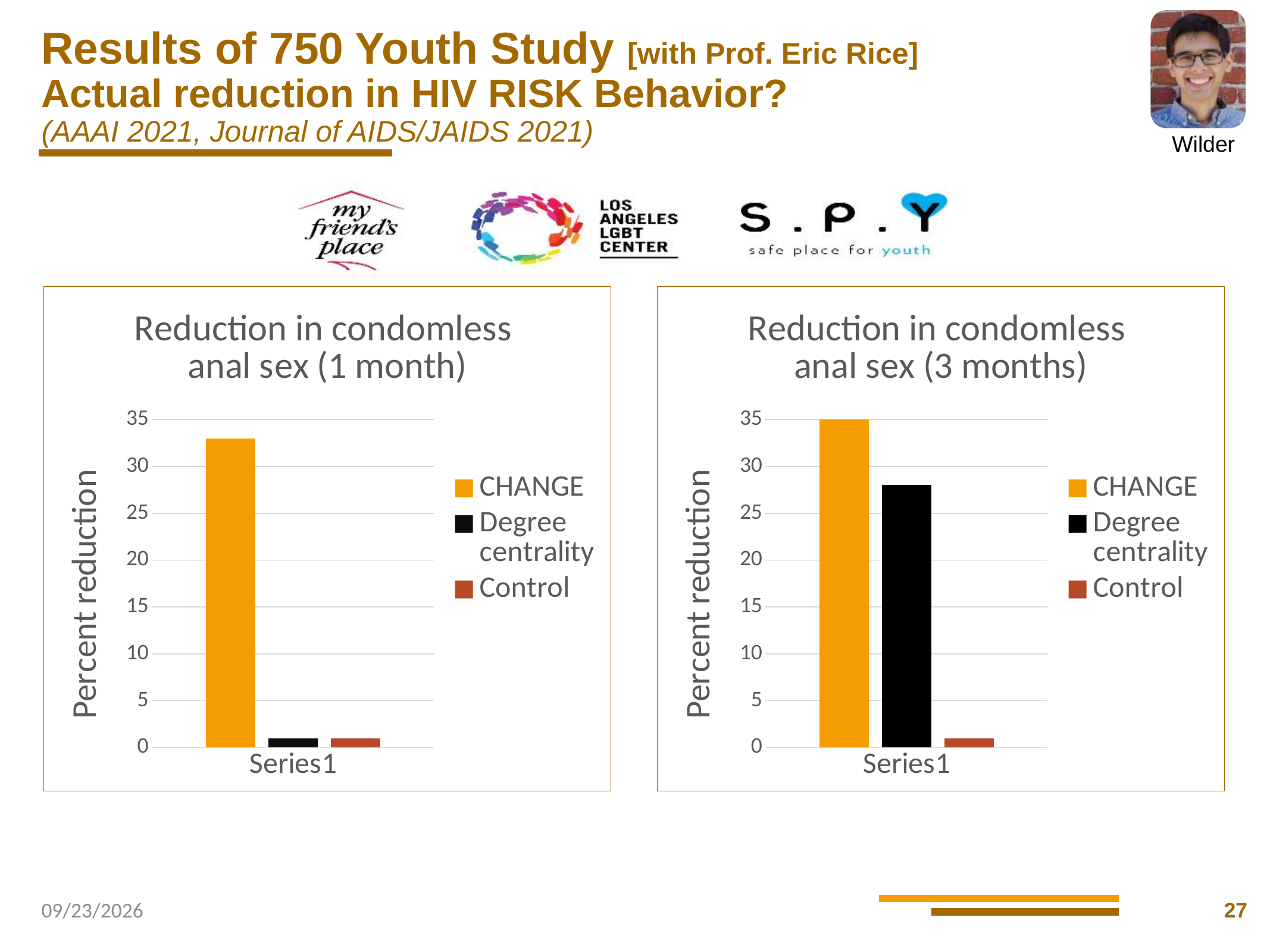
In the 'Reduction in condomless anal sex (3 months)' chart, which is larger, the value for CHANGE or the value for Degree centrality? CHANGE In the 'Reduction in condomless anal sex (3 months)' chart, is the value for Control greater or less than 5? less In the 'Reduction in condomless anal sex (1 month)' chart, which is larger, the value for CHANGE or the value for Degree centrality? CHANGE In the 'Reduction in condomless anal sex (3 months)' chart, which series has the lowest percent reduction? Control In the 'Reduction in condomless anal sex (3 months)' chart, which series has the highest percent reduction? CHANGE How many series does the legend list in the 'Reduction in condomless anal sex (3 months)' chart? 3 What is the y-axis label of the 'Reduction in condomless anal sex (3 months)' chart? Percent reduction In the 'Reduction in condomless anal sex (3 months)' chart, is the value for Degree centrality greater or less than 25? greater In the 'Reduction in condomless anal sex (1 month)' chart, is the value for CHANGE greater or less than 30? greater What kind of chart is the 'Reduction in condomless anal sex (1 month)' chart? bar chart In the 'Reduction in condomless anal sex (1 month)' chart, which series has the highest percent reduction? CHANGE